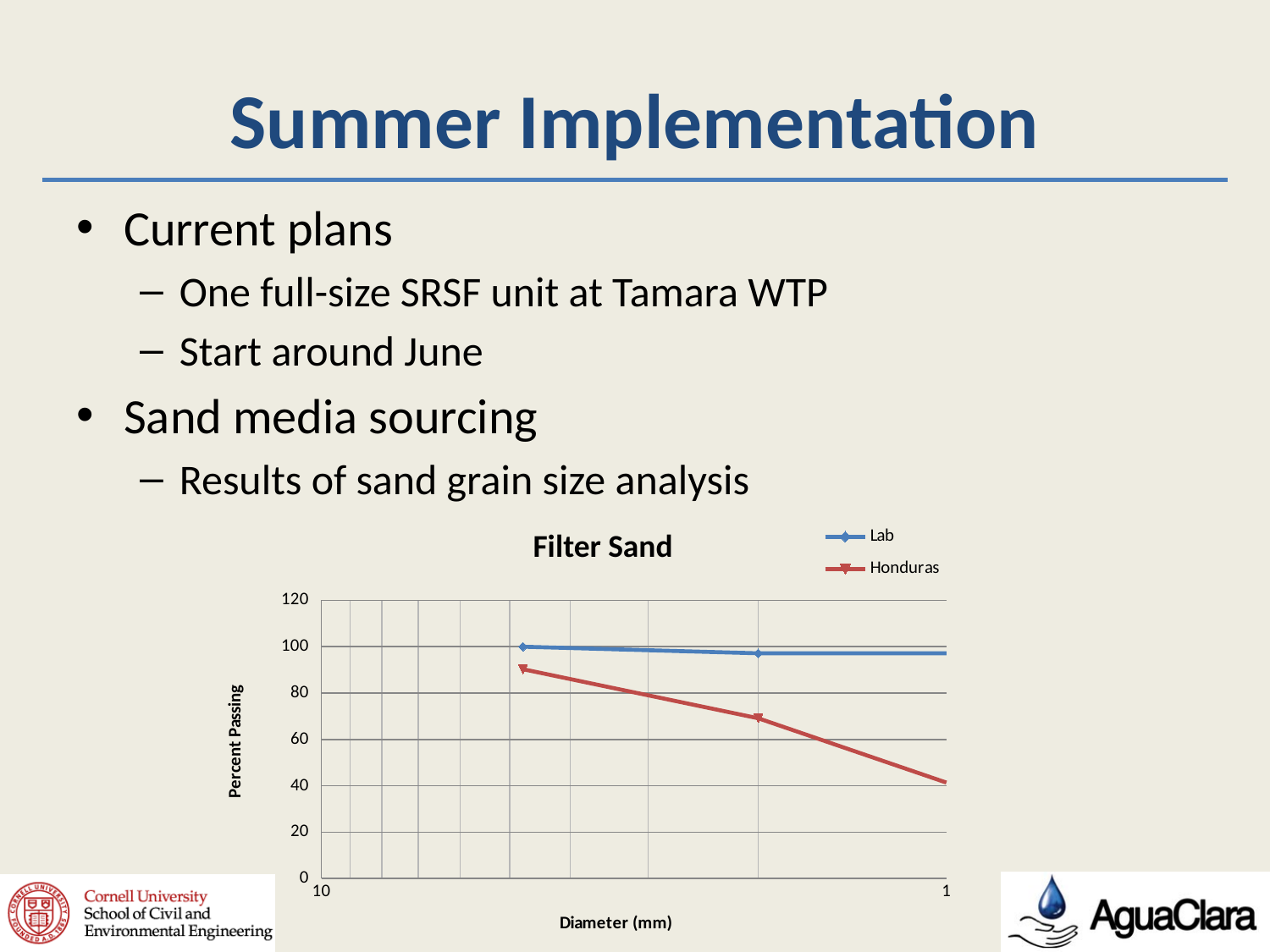
What is the title of the chart on the slide? Filter Sand How many series does the legend of the Filter Sand chart list? 2 What kind of chart is the Filter Sand chart? line chart In the Filter Sand chart, is the Lab value at a diameter of 1 mm greater or less than 80? greater In the Filter Sand chart, which series has the higher percent passing at a diameter of 1 mm, Lab or Honduras? Lab In the Filter Sand chart, is the Lab value at its leftmost plotted point greater or less than 80? greater In the Filter Sand chart, is the Honduras value at its leftmost plotted point greater or less than 80? greater What is the label of the y axis on the Filter Sand chart? Percent Passing In the Filter Sand chart, which series stays closer to 100 percent passing across the plotted diameters? Lab In the Filter Sand chart, does the Honduras series rise or fall moving from left to right along the x axis? fall